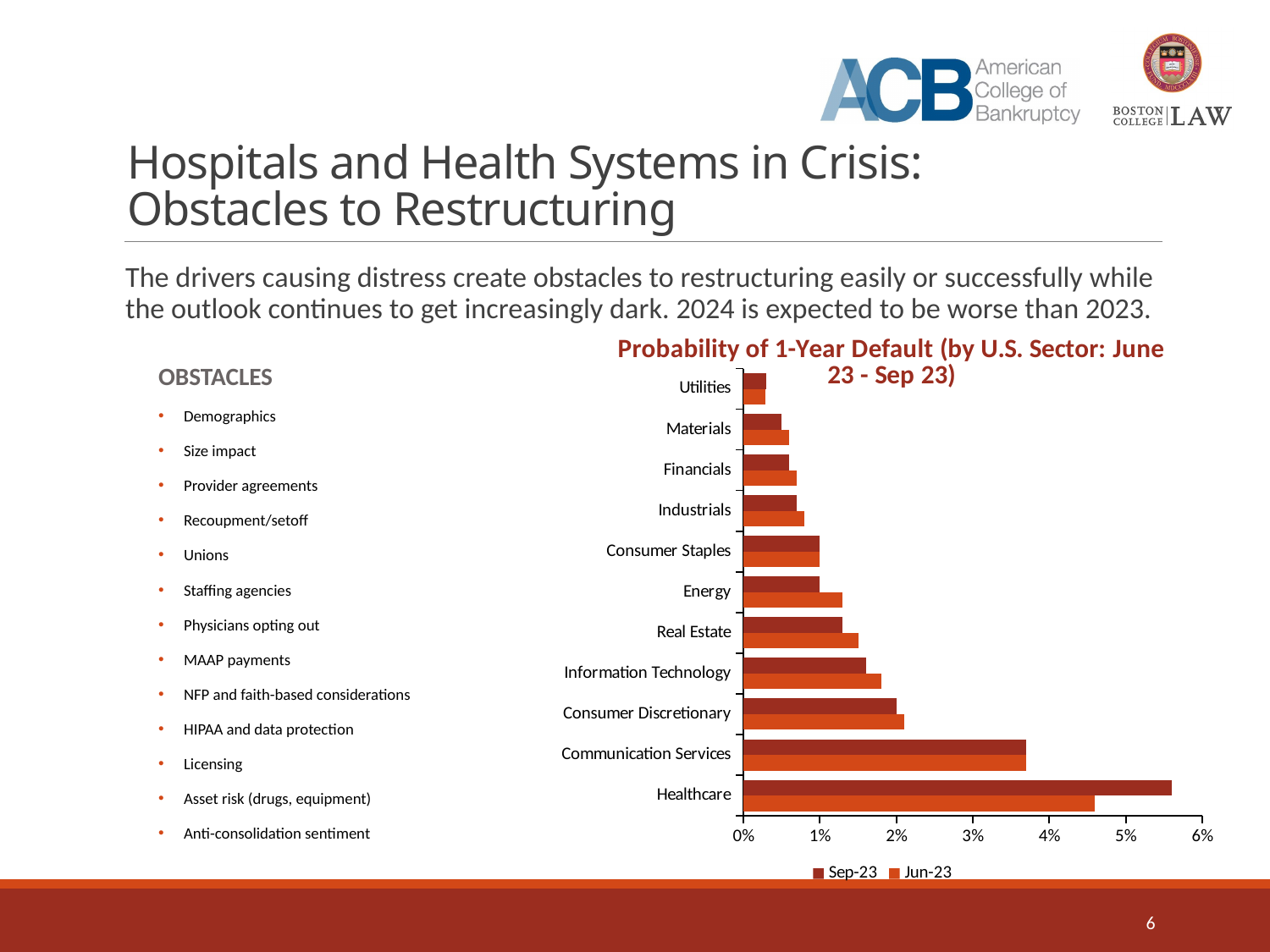
How many sectors are plotted in the chart? 11 What kind of chart is shown on the slide? Bar chart Is the Sep-23 value for Healthcare greater or less than 5%? greater For Energy, which is larger: the Sep-23 value or the Jun-23 value? Jun-23 Is the Sep-23 value for Information Technology greater or less than 2%? less Is the Jun-23 value for Healthcare greater or less than 5%? less Which sector has the lowest probability of 1-year default for Sep-23? Utilities For Healthcare, which is larger: the Sep-23 value or the Jun-23 value? Sep-23 How many series does the chart's legend list? 2 Which sector has the highest probability of 1-year default for Sep-23? Healthcare What is the title of the chart? Probability of 1-Year Default (by U.S. Sector: June 23 - Sep 23)